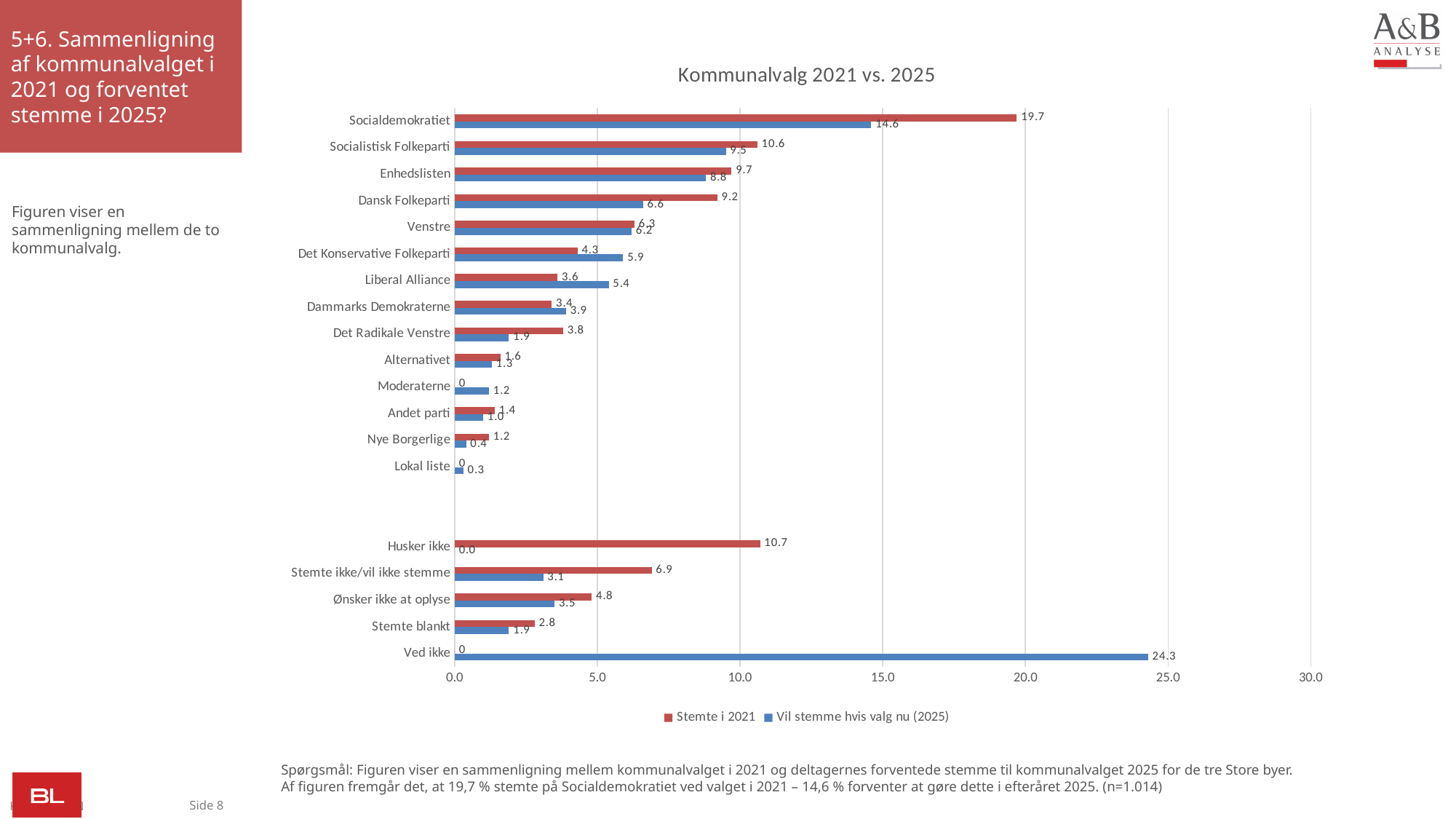
What is the value for Ved ikke in the 'Vil stemme hvis valg nu (2025)' series? 24.3 Which is larger for Det Konservative Folkeparti: the 'Stemte i 2021' value or the 'Vil stemme hvis valg nu (2025)' value? Vil stemme hvis valg nu (2025) What kind of chart is shown on the slide? Bar chart What is the title of the chart? Kommunalvalg 2021 vs. 2025 What is the value for Liberal Alliance in the 'Vil stemme hvis valg nu (2025)' series? 5.4 Which category has the highest value in the 'Vil stemme hvis valg nu (2025)' series? Ved ikke What is the value for Socialdemokratiet in the 'Stemte i 2021' series? 19.7 Is the 'Stemte i 2021' value for Husker ikke greater or less than 10.0? greater What is the difference between the 'Stemte i 2021' and 'Vil stemme hvis valg nu (2025)' values for Dansk Folkeparti? 2.6 Which category has the highest value in the 'Stemte i 2021' series? Socialdemokratiet How many categories are shown on the y axis of the chart? 19 How many series does the legend list? 2